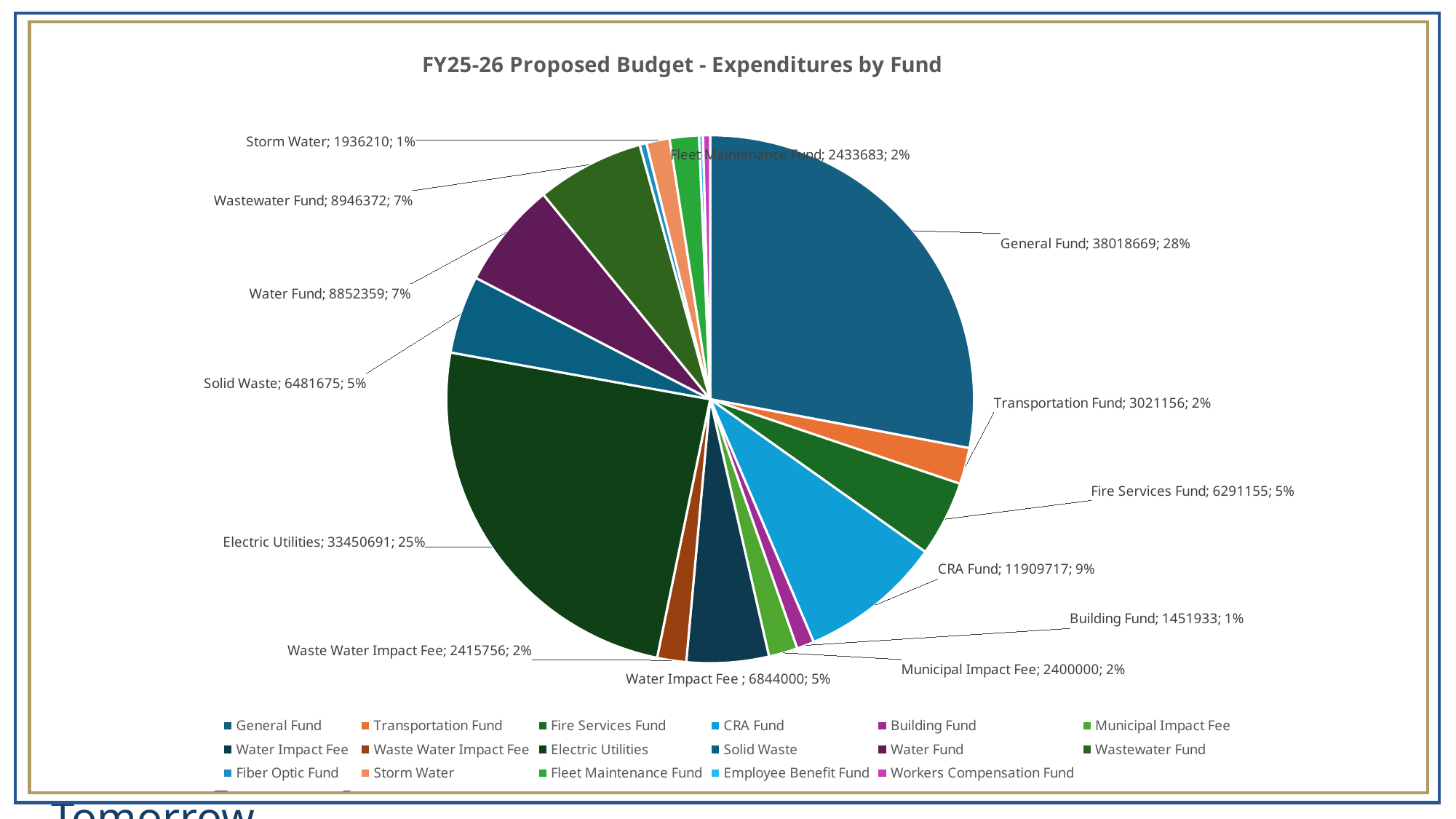
How many funds are listed in the legend? 17 What is the difference between the CRA Fund and Fire Services Fund expenditures? 5618562 What is the difference between the General Fund and Electric Utilities expenditures? 4567978 Which fund has the largest expenditure? General Fund Which is larger, the Water Impact Fee or the Transportation Fund expenditure? Water Impact Fee What type of chart is shown on the slide? Pie chart What share of the pie does Electric Utilities represent? 25% What is the expenditure value for the CRA Fund? 11909717 What share of the pie does the Wastewater Fund represent? 7% What is the expenditure value for Solid Waste? 6481675 What is the title of the chart? FY25-26 Proposed Budget - Expenditures by Fund What is the expenditure value for the General Fund? 38018669